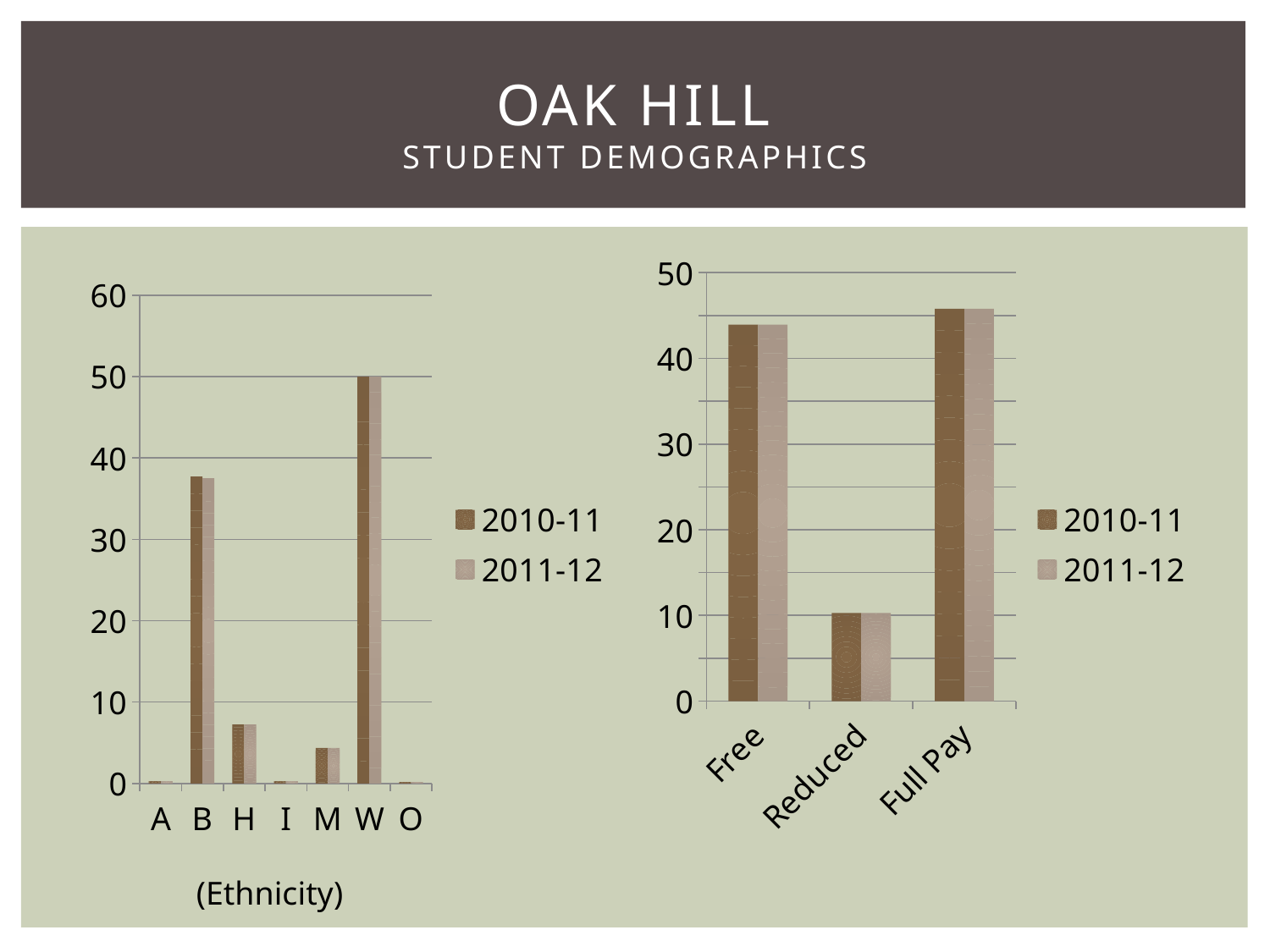
On the Ethnicity chart on the left, how many series does the legend list? 2 On the chart on the right, is the 2010-11 value for Free greater or less than 40? greater On the Ethnicity chart on the left, is the 2010-11 value for B greater or less than 30? greater On the chart on the right, how many categories are shown on the x axis? 3 On the chart on the right, what are the two series listed in the legend? 2010-11 and 2011-12 On the chart on the right, which category has the lowest bars? Reduced On the Ethnicity chart on the left, what kind of chart is shown? bar chart On the Ethnicity chart on the left, how many ethnicity categories are shown on the x axis? 7 On the Ethnicity chart on the left, which category has the highest bars? W On the Ethnicity chart on the left, is the 2011-12 value for H greater or less than 10? less On the Ethnicity chart on the left, which has the larger 2010-11 value, B or M? B